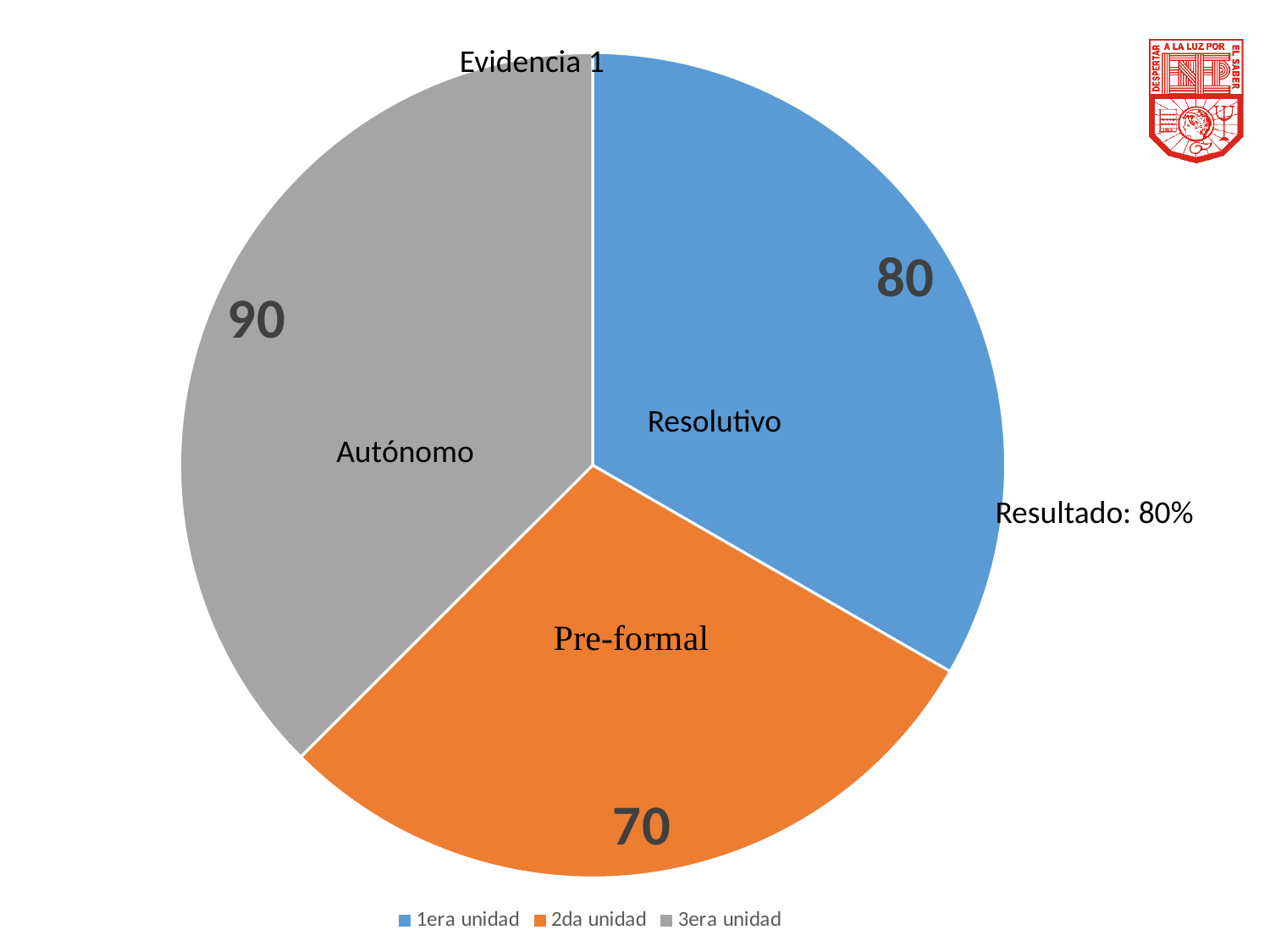
How many entries does the legend list? 3 Which is larger, the value for 1era unidad or the value for 2da unidad? 1era unidad What is the value for 2da unidad? 70 What is the difference between the values for 3era unidad and 2da unidad? 20 Which unit has the largest slice of the pie? 3era unidad What kind of chart is shown on the slide? Pie chart What is the title of the chart? Evidencia 1 What share of the pie does 3era unidad represent? 37.5% Which unit has the smallest slice of the pie? 2da unidad What is the value for 1era unidad? 80 What is the value for 3era unidad? 90 How many slices does the pie chart have? 3